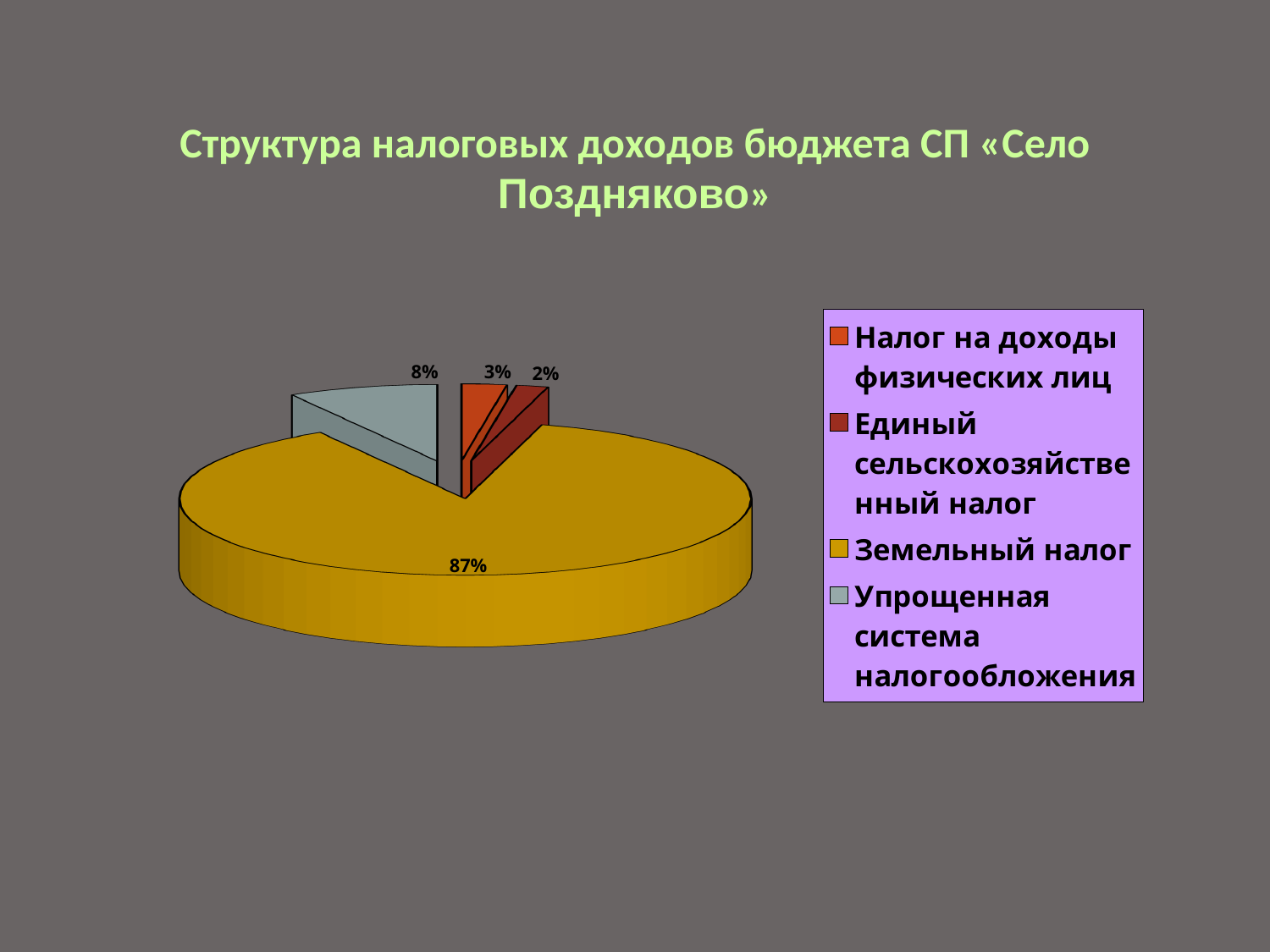
What colour is the slice for Земельный налог? yellow What is the difference in percentage points between Земельный налог and Упрощенная система налогообложения? 79 What share of tax revenues does Земельный налог account for? 87% What type of chart is shown on the slide? pie chart How many slices does the pie chart have? 4 What is the title of the chart? Структура налоговых доходов бюджета СП «Село Поздняково» Which category has the largest share of the pie? Земельный налог Which category has the smallest share of the pie? Единый сельскохозяйственный налог What share of tax revenues does Упрощенная система налогообложения account for? 8% What share of tax revenues does Единый сельскохозяйственный налог account for? 2% Which is larger: the share of Налог на доходы физических лиц or the share of Единый сельскохозяйственный налог? Налог на доходы физических лиц What share of tax revenues does Налог на доходы физических лиц account for? 3%